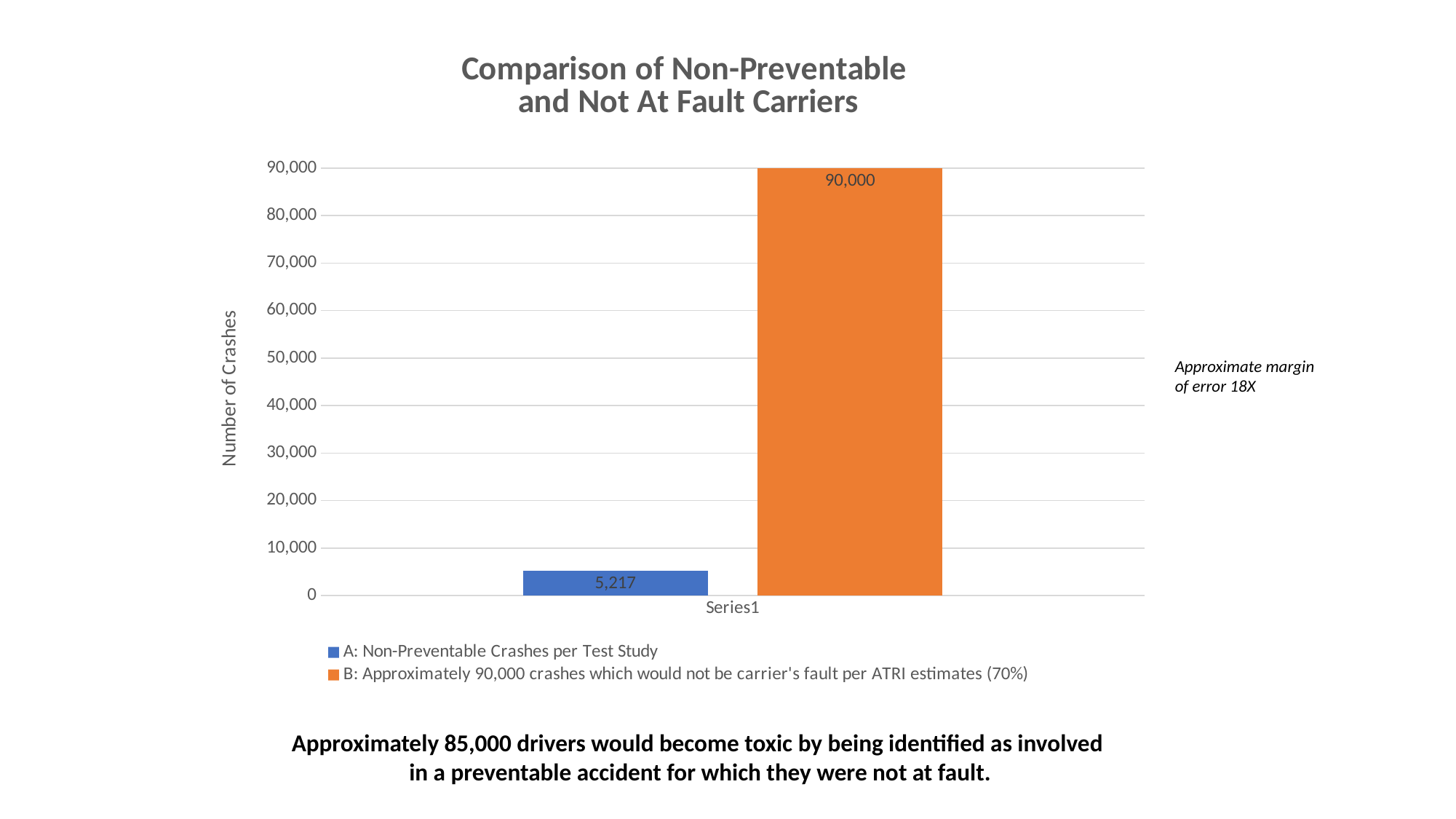
Which series has the lower value, A or B? A Which series has the higher value, A or B? B What is the label on the vertical axis of the chart? Number of Crashes Is the value for series B greater or less than 80,000? greater What is the value of the bar for series A: Non-Preventable Crashes per Test Study? 5,217 What is the title of the chart? Comparison of Non-Preventable and Not At Fault Carriers What is the value of the orange bar for series B? 90,000 What is the category label shown on the x axis? Series1 What kind of chart is shown on the slide? bar chart How many series does the legend list? 2 What is the difference between the value for series B and the value for series A? 84,783 Is the value for series A greater or less than 10,000? less